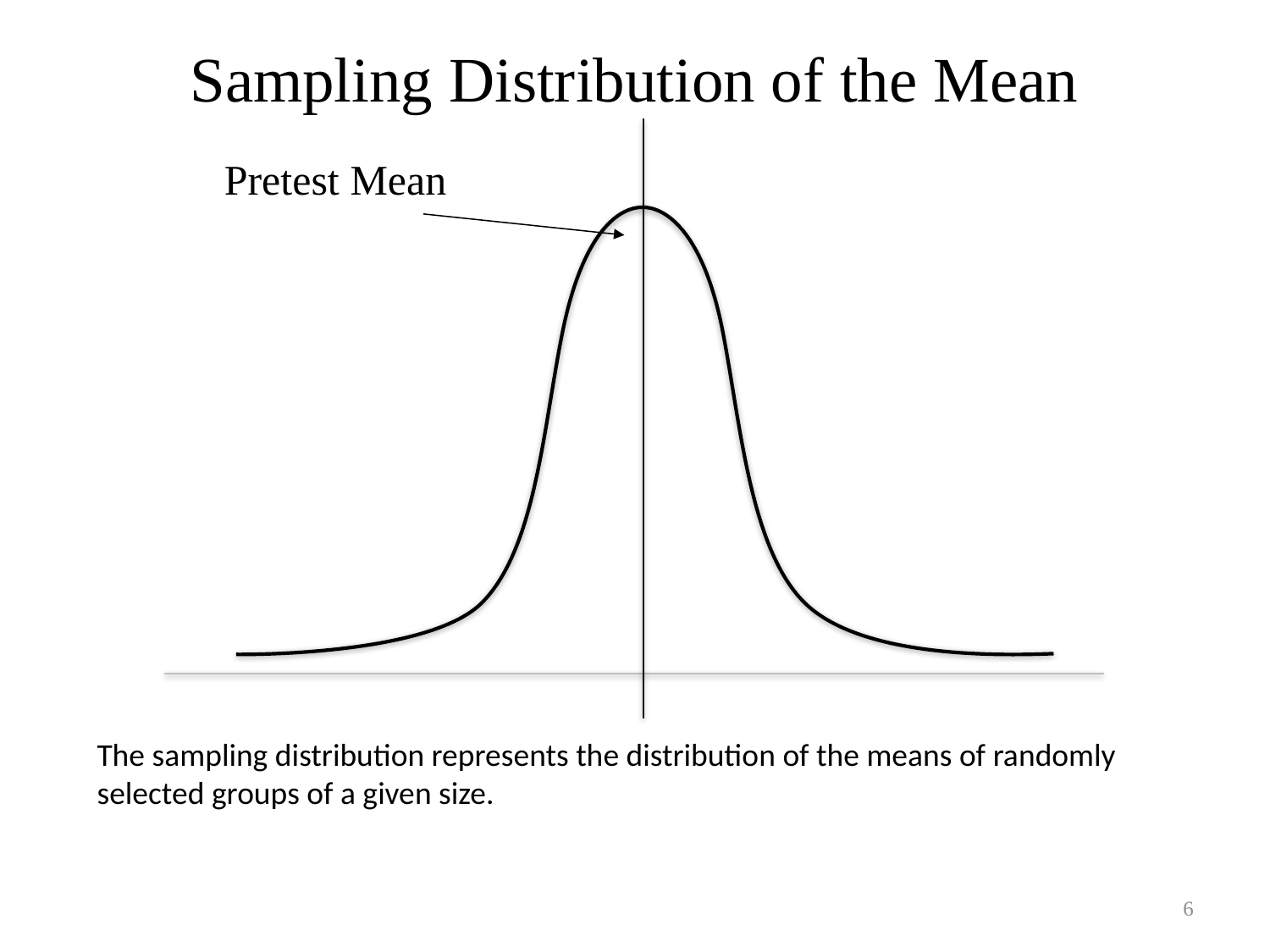
What is the title of the chart? Sampling Distribution of the Mean How many curves are plotted on the chart? 1 What label does the arrow pointing at the peak of the curve carry? Pretest Mean Moving from the left end of the curve toward the vertical line, does the curve rise or fall? rise Moving from the vertical line toward the right end of the curve, does the curve rise or fall? fall What kind of chart is shown on the slide? line chart